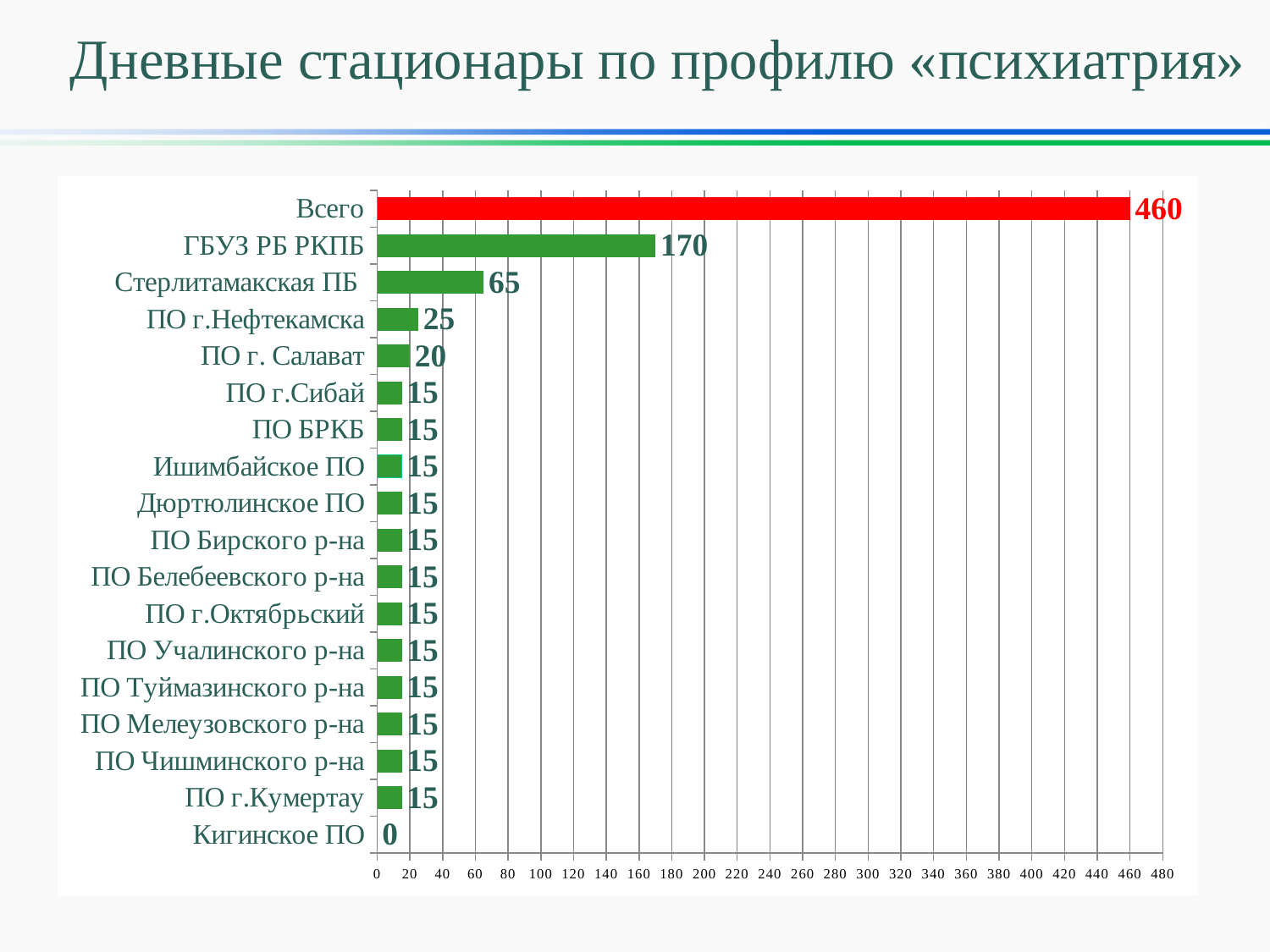
Excluding Всего, which category has the highest value? ГБУЗ РБ РКПБ What is the title of the slide? Дневные стационары по профилю «психиатрия» What is the value for Кигинское ПО? 0 What is the value for Стерлитамакская ПБ? 65 What is the value for ПО г. Салават? 20 Which category has the lowest value? Кигинское ПО How many categories are shown on the chart? 18 What is the difference between the values for ГБУЗ РБ РКПБ and Стерлитамакская ПБ? 105 What is the value for Всего? 460 What is the value for ГБУЗ РБ РКПБ? 170 Which is larger, the value for ПО г.Нефтекамска or the value for ПО г. Салават? ПО г.Нефтекамска What type of chart is shown on the slide? Bar chart